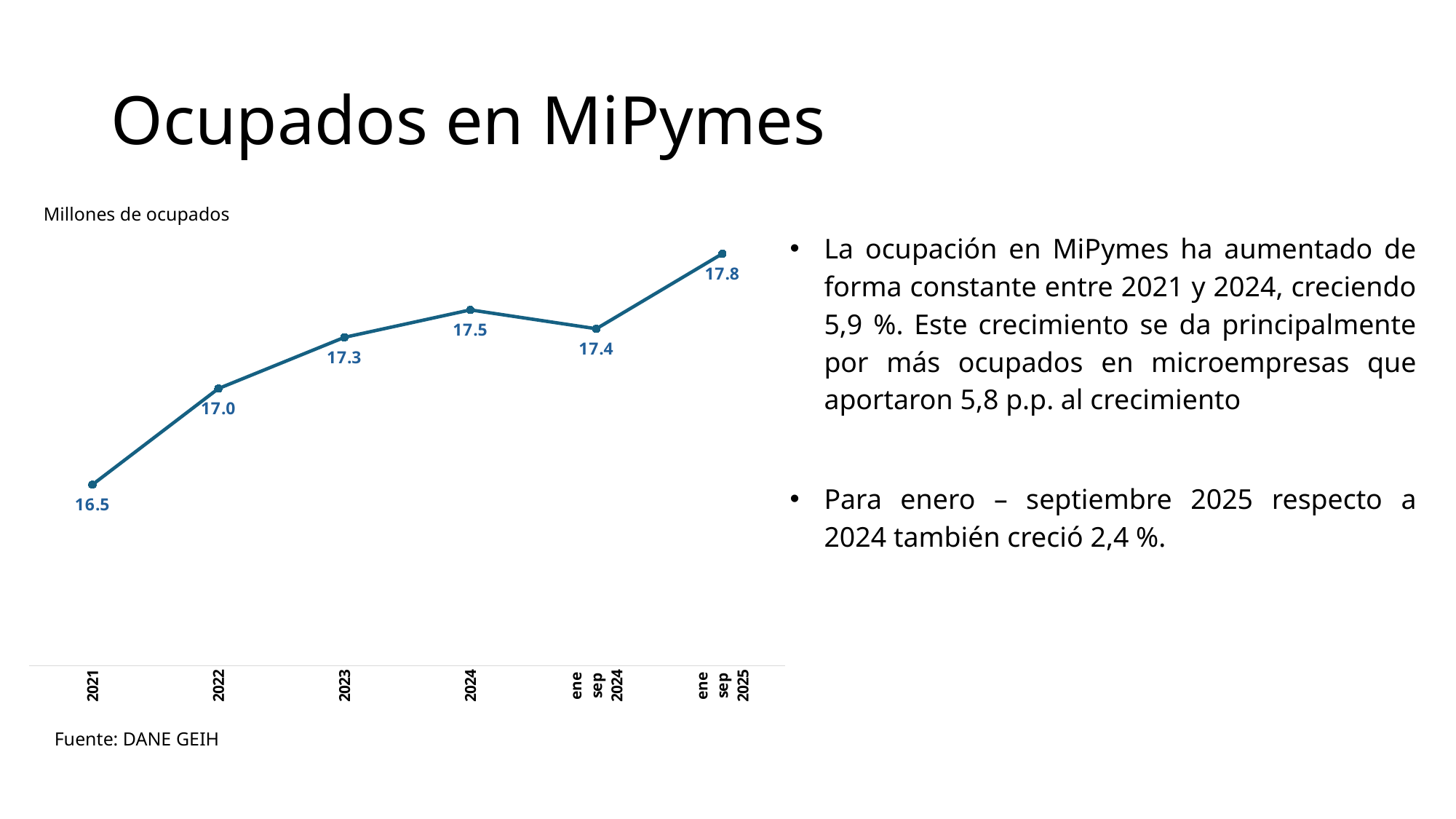
Which point has the highest value? ene-sep 2025 What is the value for ene-sep 2024? 17.4 What is the value for ene-sep 2025? 17.8 Which point has the lowest value? 2021 What is the difference between the values for ene-sep 2025 and ene-sep 2024? 0.4 Which is larger, the value for 2022 or the value for 2023? 2023 What unit is stated above the chart? Millones de ocupados What kind of chart is shown on the slide? Line chart How many data points are plotted on the chart? 6 What is the value for 2023? 17.3 What is the difference between the values for 2024 and 2021? 1.0 What is the value for 2021? 16.5